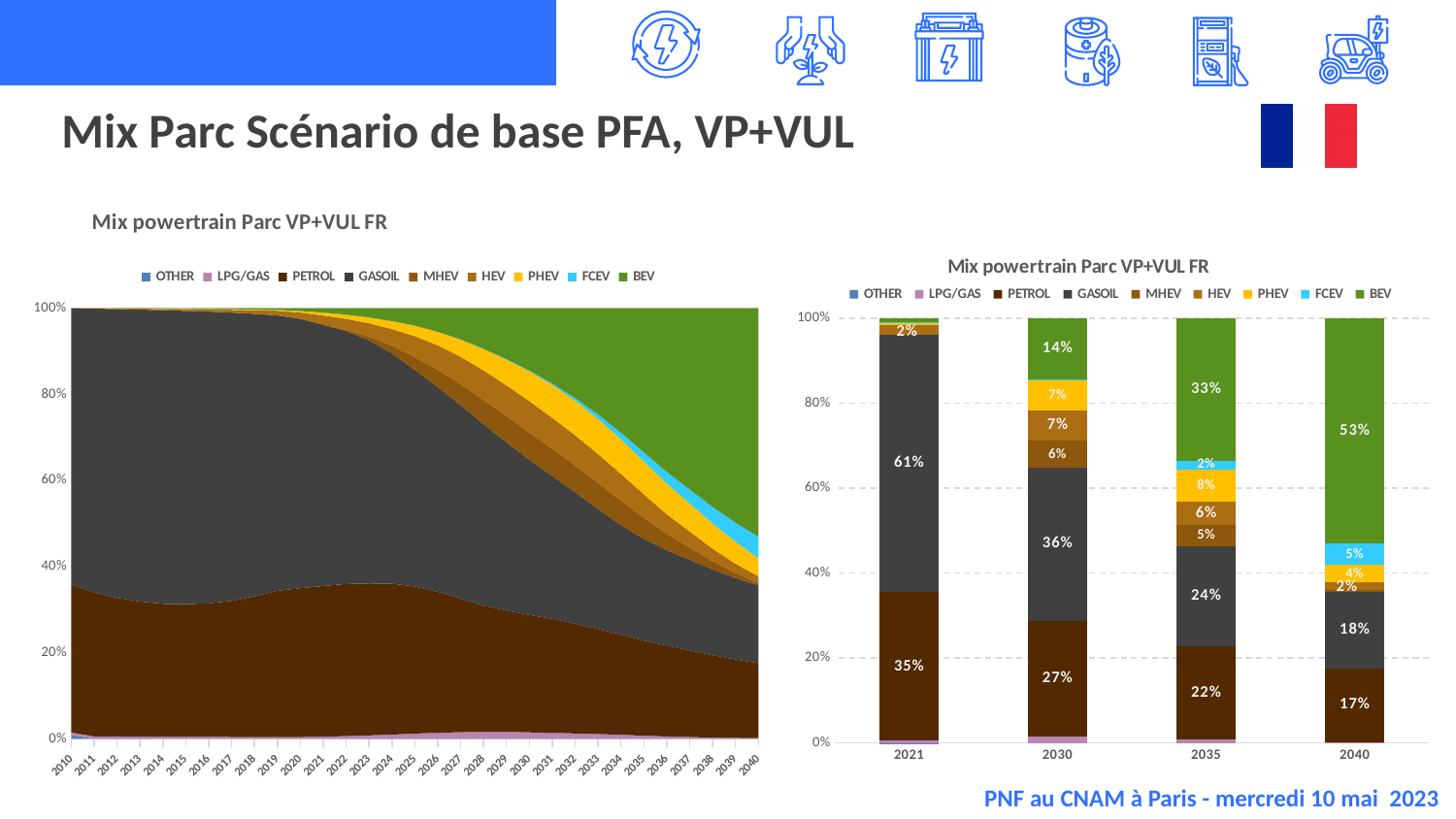
In the bar chart on the right, what is the BEV share in 2040? 53% What kind of chart is the chart on the left? Stacked area chart In the chart on the left, does the BEV share rise or fall from 2010 to 2040? Rise In the bar chart on the right, what is the PHEV share in 2035? 8% How many years are shown on the x axis of the bar chart on the right? 4 In the bar chart on the right, what is the GASOIL share in 2021? 61% In the bar chart on the right, is the PETROL share larger in 2021 or in 2040? 2021 How many series does the legend of the bar chart on the right list? 9 In the bar chart on the right, by how many percentage points does the BEV share in 2040 exceed the BEV share in 2030? 39 percentage points In the bar chart on the right, which year has the highest BEV share? 2040 In the bar chart on the right, what is the PETROL share in 2030? 27% What is the title of the chart on the left? Mix powertrain Parc VP+VUL FR